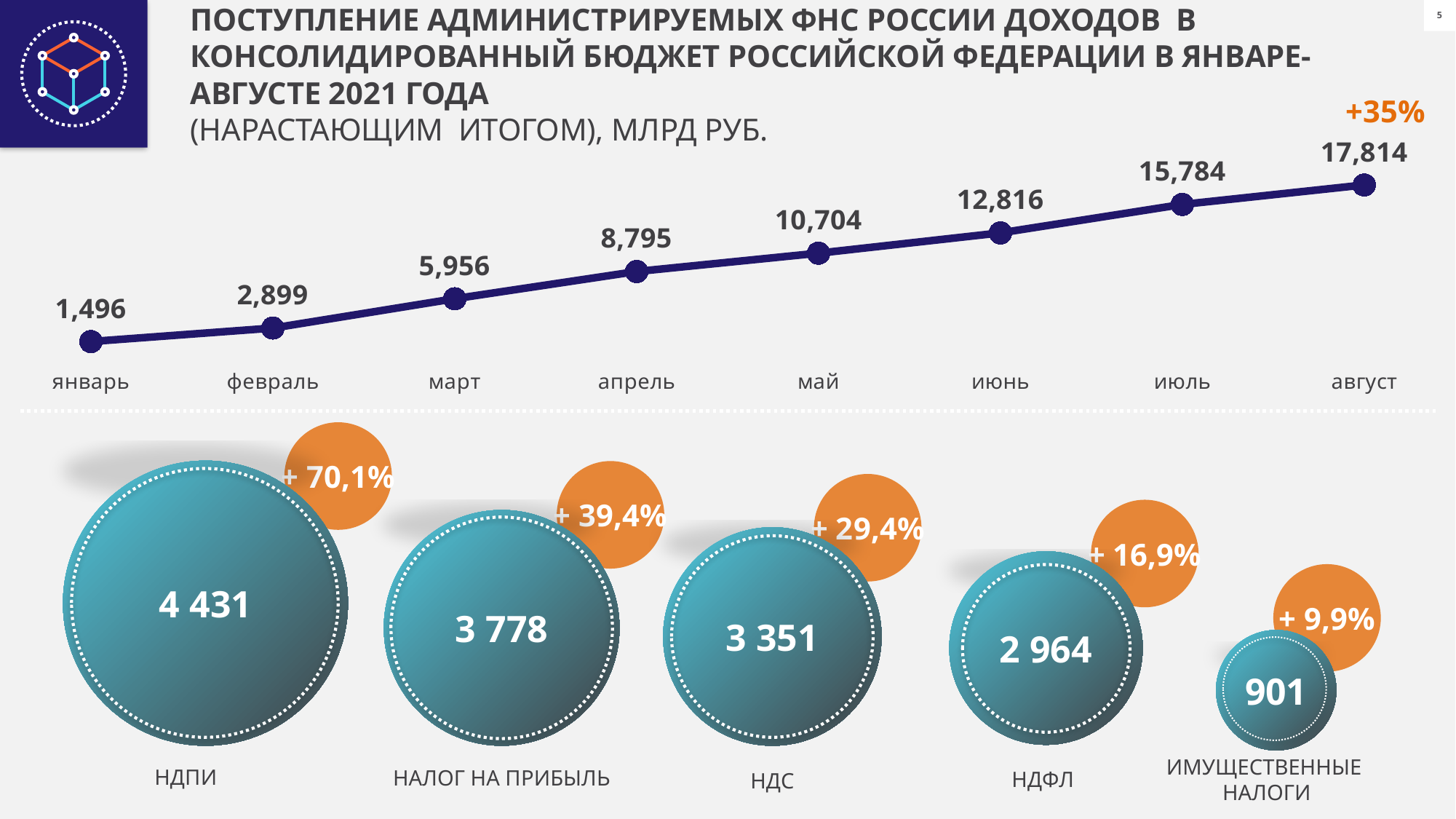
How many data points are plotted on the line chart? 8 On the line chart, which month has the highest value? август In the bubble chart at the bottom, which category has the largest value? НДПИ In the bubble chart at the bottom, what is the value for НДС? 3 351 On the line chart, what is the value for март? 5,956 What type of chart is shown in the upper part of the slide? line chart On the line chart, do the values rise or fall from январь to август? rise On the line chart, what is the value for август? 17,814 On the line chart, what is the difference between the values for август and июль? 2,030 On the line chart, what is the value for январь? 1,496 On the line chart, which is larger: the value for май or the value for апрель? май On the line chart, which month has the lowest value? январь